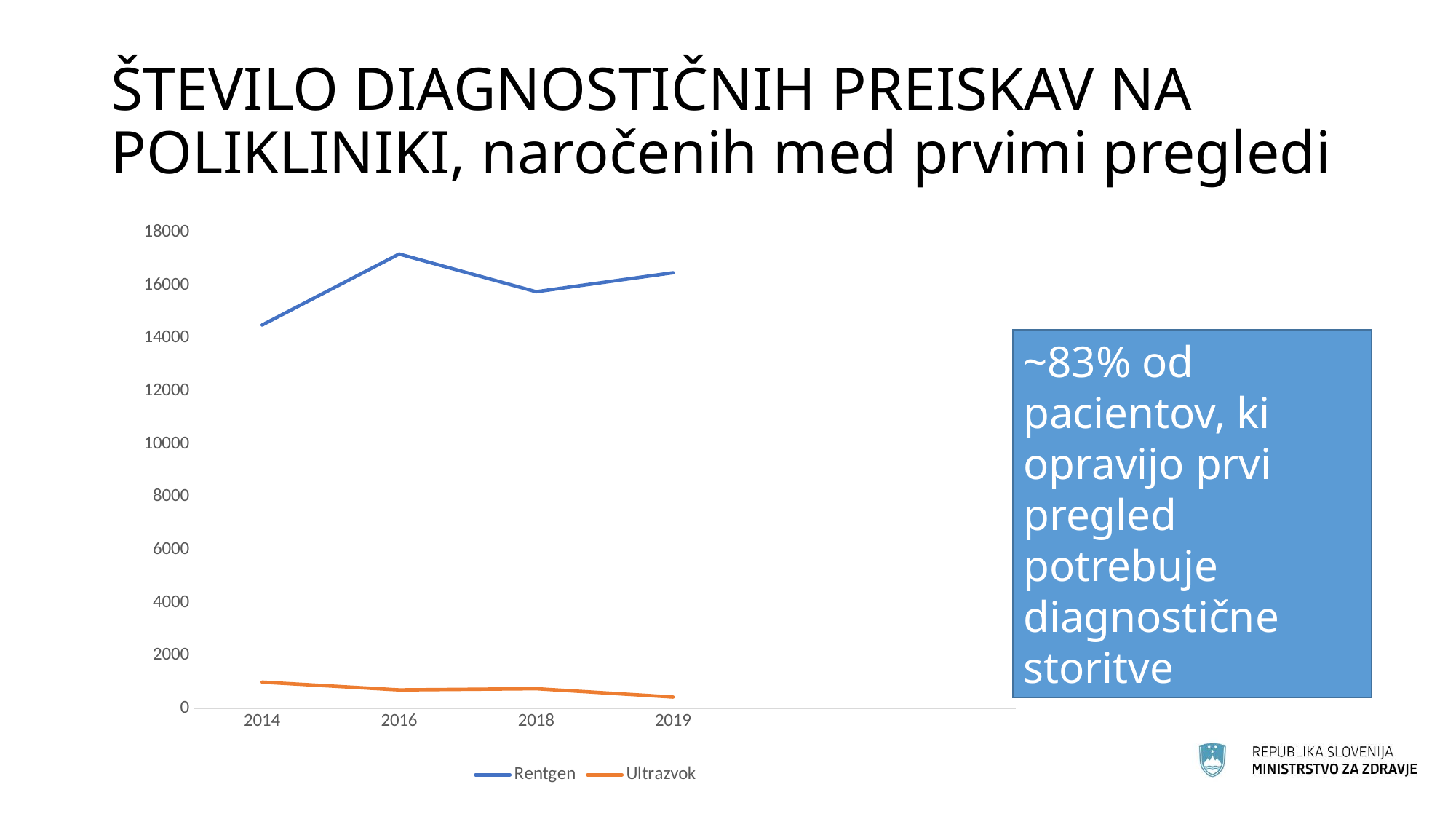
How many series does the legend list? 2 Is the value for Ultrazvok in 2019 greater or less than 2000? less In which year is the Rentgen series lowest? 2014 Which series are listed in the legend? Rentgen and Ultrazvok Is the value for Rentgen in 2016 greater or less than 16000? greater What colour is the Rentgen line? blue Does the Ultrazvok series rise or fall from 2014 to 2019? fall How many years are shown on the x axis? 4 Is the value for Rentgen in 2014 greater or less than 16000? less What kind of chart is shown on the slide? line chart Which series has the larger value in 2018, Rentgen or Ultrazvok? Rentgen In which year is the Rentgen series highest? 2016